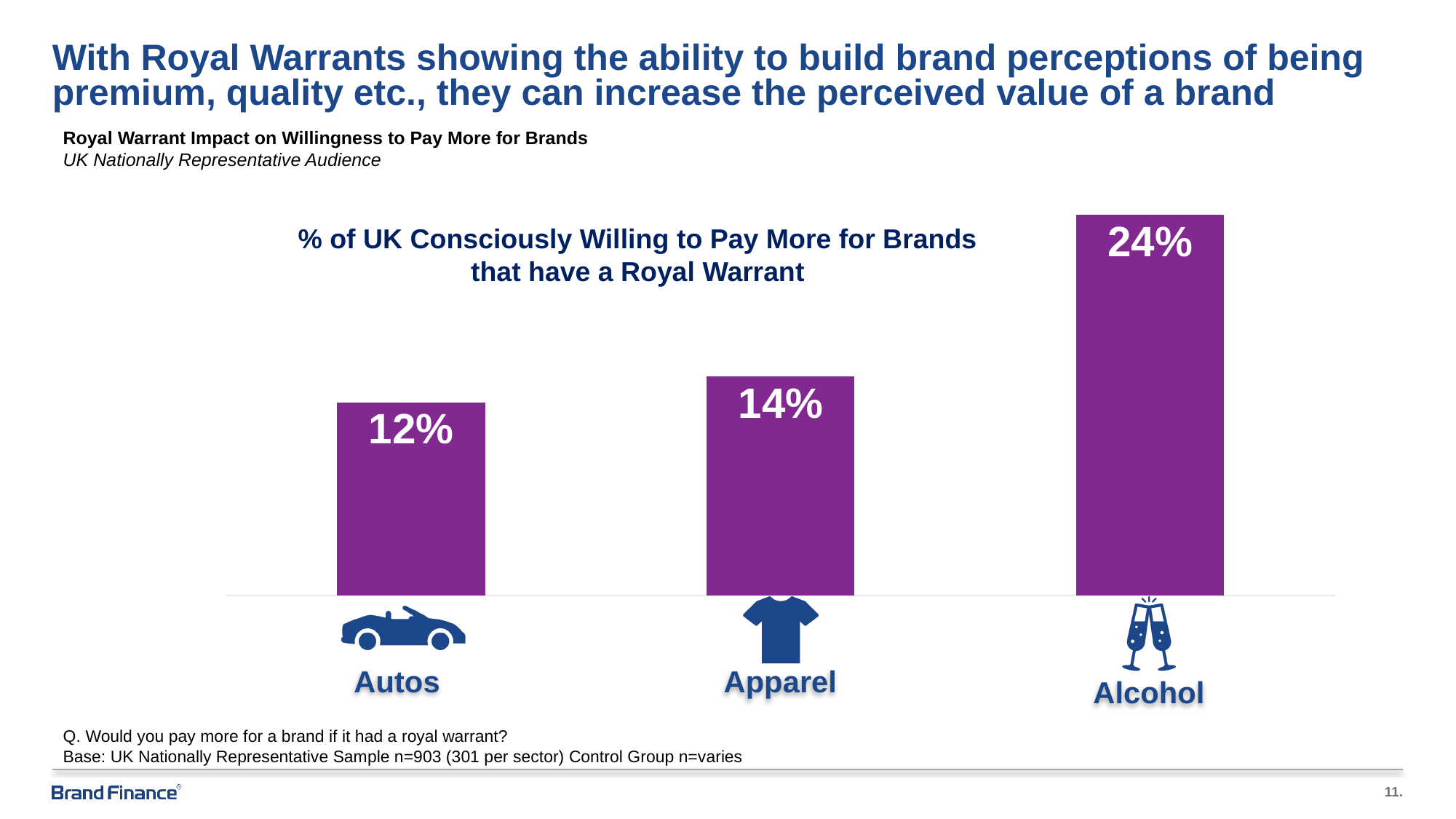
What kind of chart is shown on the slide? Bar chart What is the value shown for Alcohol in the chart? 24% What is the title of the chart? % of UK Consciously Willing to Pay More for Brands that have a Royal Warrant What percentage of UK respondents are consciously willing to pay more for Autos brands that have a Royal Warrant? 12% What is the difference in percentage points between Alcohol and Autos? 12 percentage points Which sector has the highest percentage of UK respondents willing to pay more for brands with a Royal Warrant? Alcohol How many sectors are shown in the chart? 3 Do the values rise or fall moving from Autos to Alcohol along the x axis? Rise Which has a higher value, Apparel or Alcohol? Alcohol Which sector has the lowest percentage of UK respondents willing to pay more for brands with a Royal Warrant? Autos What is the value shown for Apparel in the chart? 14% What is the difference in percentage points between Apparel and Autos? 2 percentage points